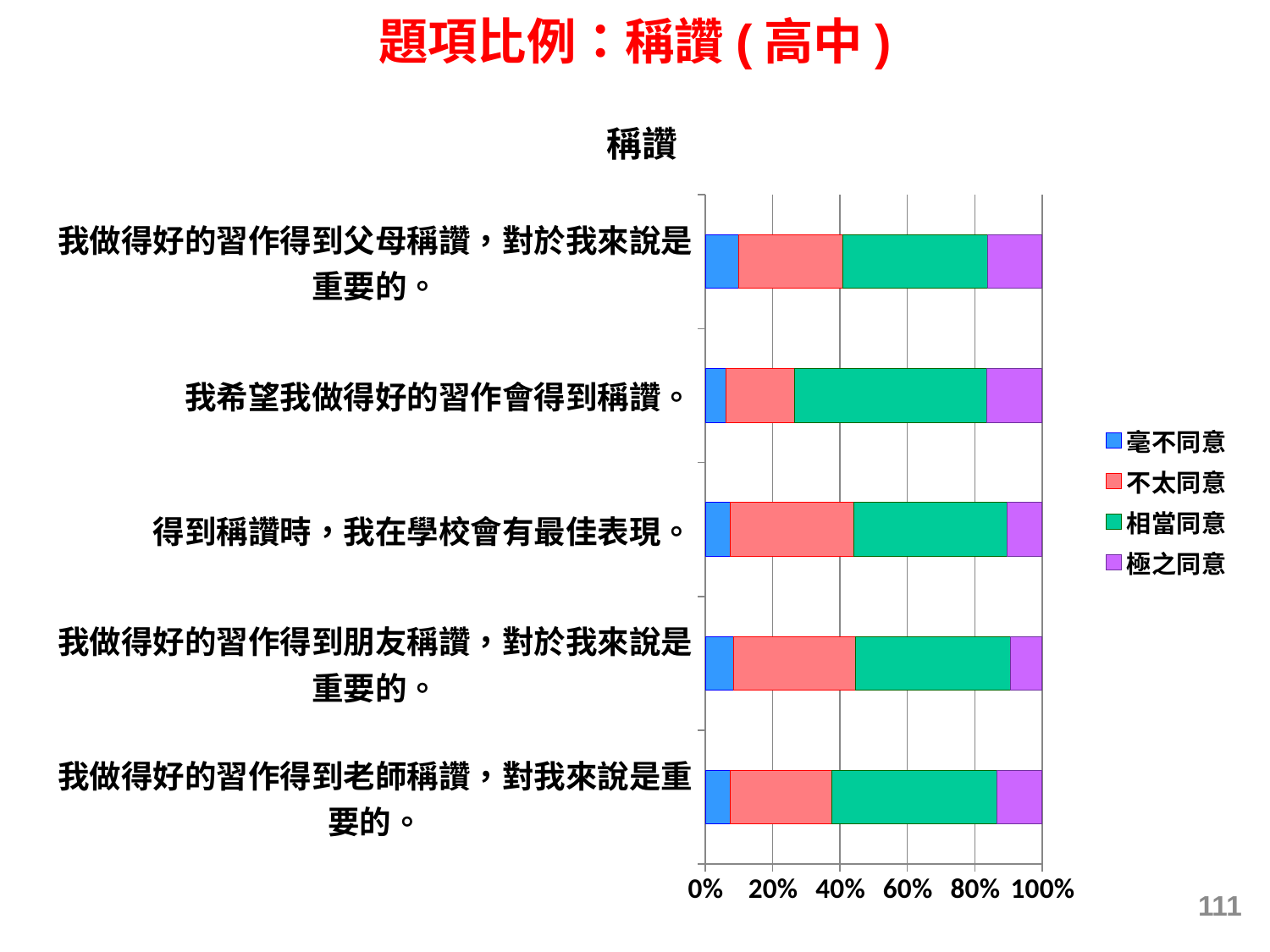
How many statements (categories) are plotted in the chart? 5 Which statement has the smallest 不太同意 segment? 我希望我做得好的習作會得到稱讚。 Which has the larger 相當同意 share: 「我希望我做得好的習作會得到稱讚。」 or 「我做得好的習作得到父母稱讚，對於我來說是重要的。」? 我希望我做得好的習作會得到稱讚。 How many series does the legend list? 4 Is the 不太同意 share for 「我希望我做得好的習作會得到稱讚。」 greater or less than 40%? less Is the 毫不同意 share for 「我做得好的習作得到父母稱讚，對於我來說是重要的。」 greater or less than 20%? less What kind of chart is shown on the slide? stacked bar chart Which legend entry is shown in green? 相當同意 Which statement has the largest 相當同意 segment? 我希望我做得好的習作會得到稱讚。 What is the title of the chart? 稱讚 What does each stacked bar total on the x axis? 100% Is the 相當同意 share for 「我希望我做得好的習作會得到稱讚。」 greater or less than 40%? greater